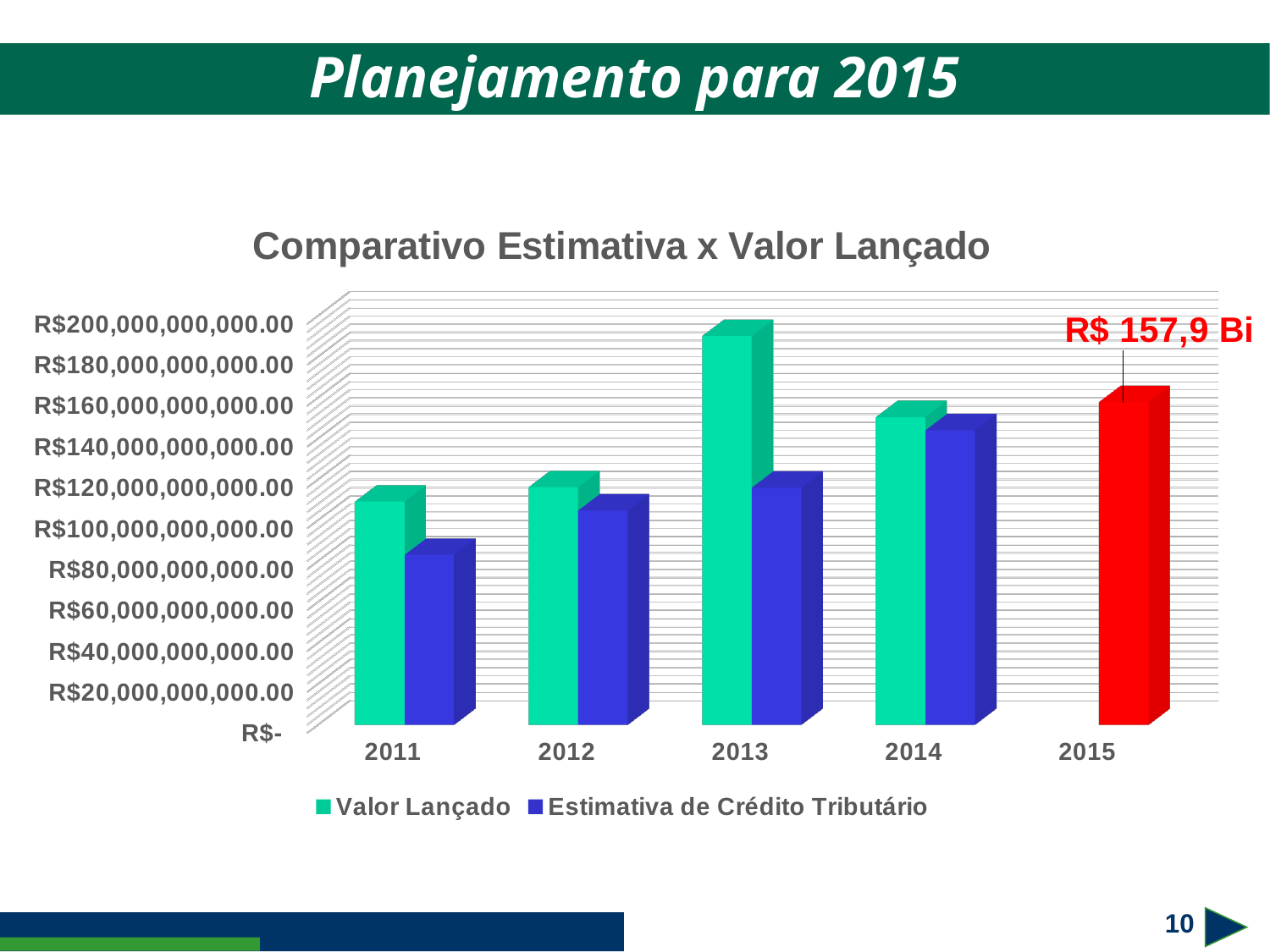
What value is labelled on the red bar for 2015? R$ 157,9 Bi What is the title of the chart? Comparativo Estimativa x Valor Lançado Is the Valor Lançado value for 2013 greater or less than R$180,000,000,000.00? greater How many years are shown on the x axis? 5 Does Estimativa de Crédito Tributário rise or fall from 2011 to 2014? Rises In which year is Valor Lançado lowest? 2011 In which year is Estimativa de Crédito Tributário lowest? 2011 In 2013, which is larger: Valor Lançado or Estimativa de Crédito Tributário? Valor Lançado What kind of chart is shown on the slide? Bar chart In which year is Valor Lançado highest? 2013 How many series does the legend list? 2 Is the Estimativa de Crédito Tributário value for 2011 greater or less than R$100,000,000,000.00? less